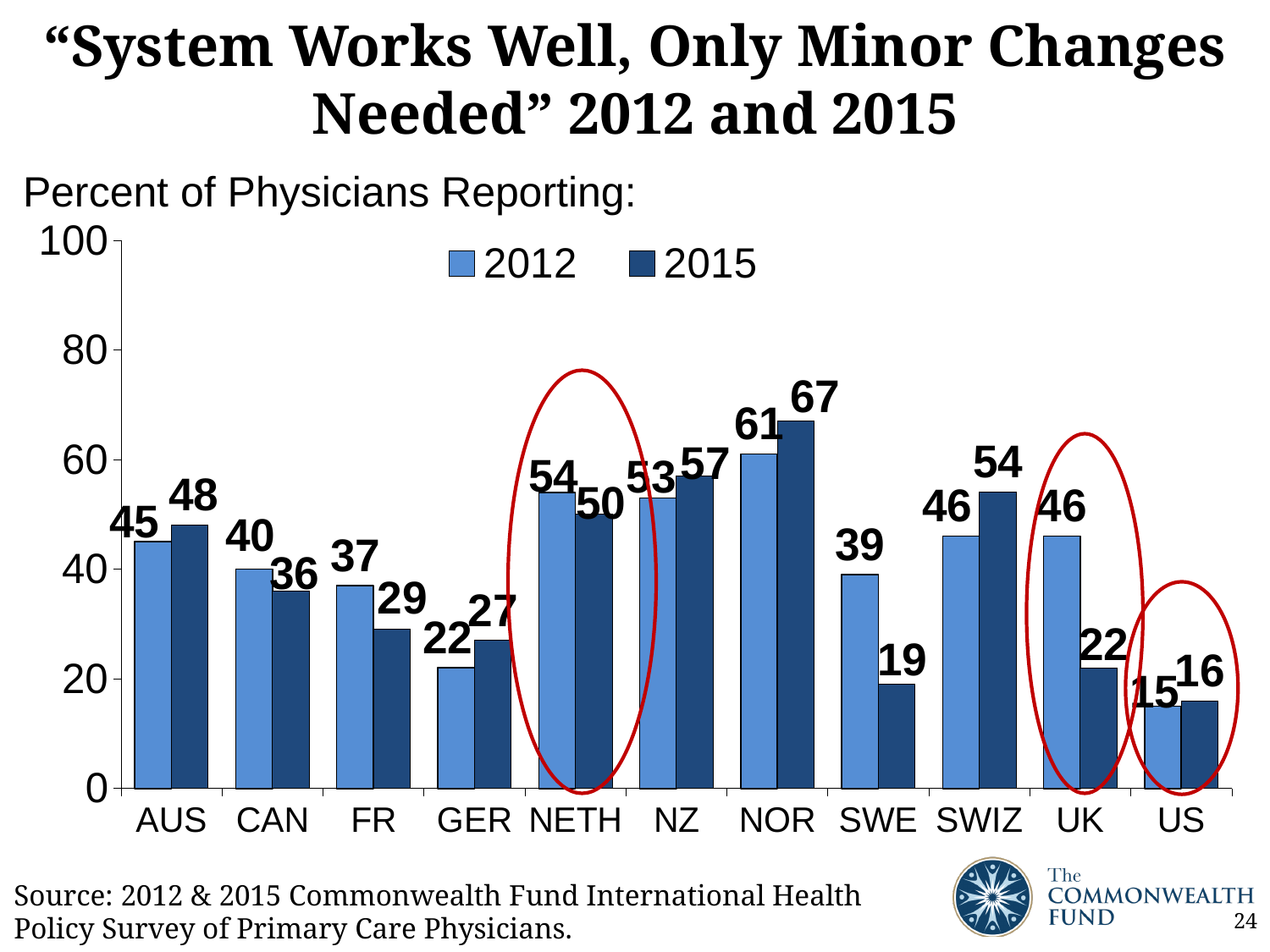
Which is larger for NETH, the 2012 value or the 2015 value? 2012 What is the difference between the 2012 and 2015 values for UK? 24 What is the 2015 value for SWE? 19 Is the 2015 value for SWIZ greater or less than 40? greater How many countries are shown on the x axis? 11 Which country has the highest 2015 value? NOR What kind of chart is shown? bar chart How many series does the legend list? 2 What are the two series listed in the legend? 2012 and 2015 What is the 2012 value for UK? 46 Which country has the lowest 2012 value? US What is the 2015 value for NOR? 67